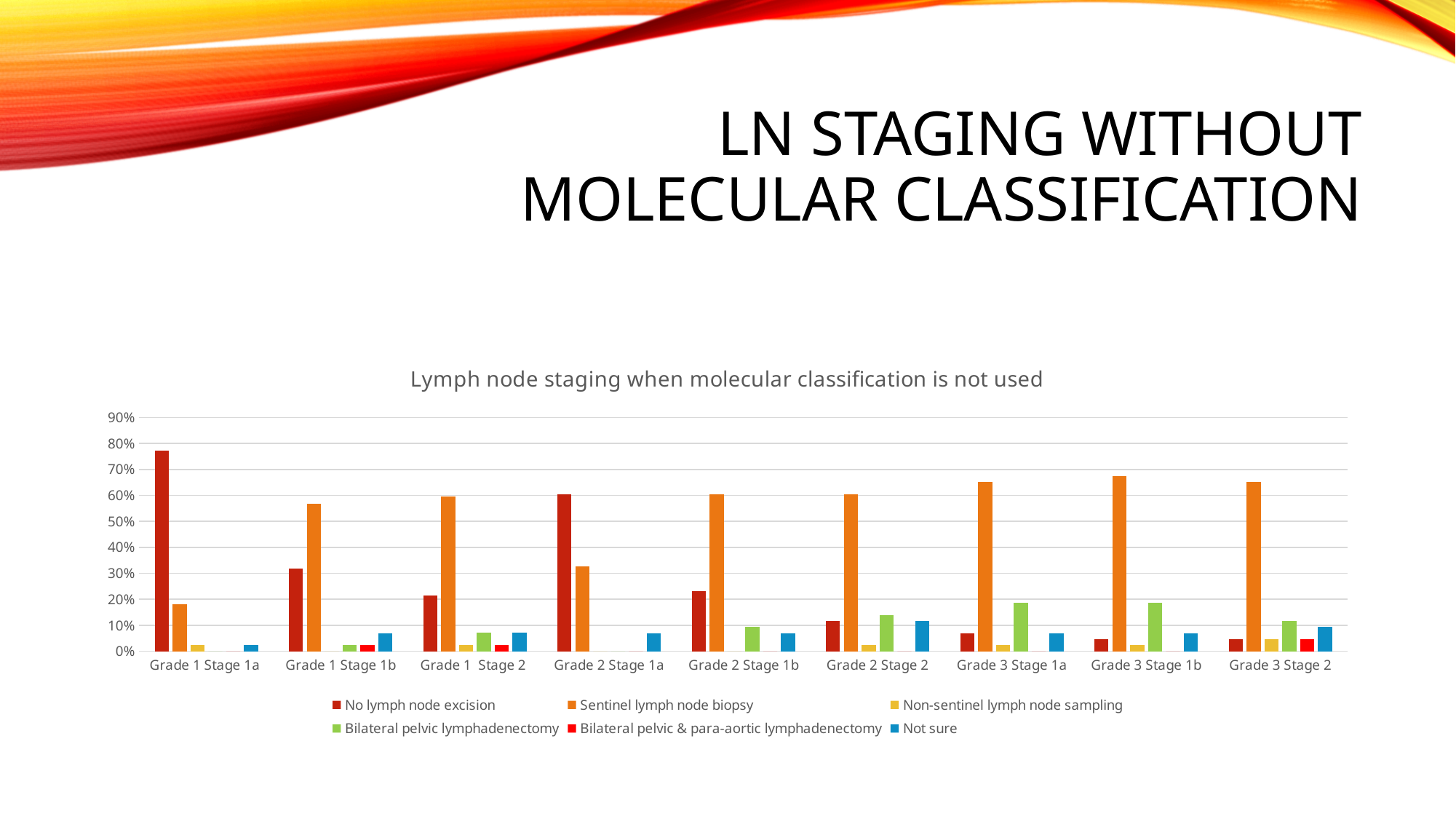
Which category has the highest value for No lymph node excision? Grade 1 Stage 1a What kind of chart is shown on the slide? Bar chart In Grade 2 Stage 1a, which is larger: No lymph node excision or Sentinel lymph node biopsy? No lymph node excision What is the title of the chart? Lymph node staging when molecular classification is not used In Grade 1 Stage 1b, which is larger: No lymph node excision or Sentinel lymph node biopsy? Sentinel lymph node biopsy How many series does the legend list? 6 How many grade/stage categories are shown on the x axis? 9 Is the value for No lymph node excision in Grade 2 Stage 1a greater or less than 50%? greater Is the value for Sentinel lymph node biopsy in Grade 3 Stage 1b greater or less than 60%? greater Is the value for Sentinel lymph node biopsy in Grade 1 Stage 1a greater or less than 30%? less